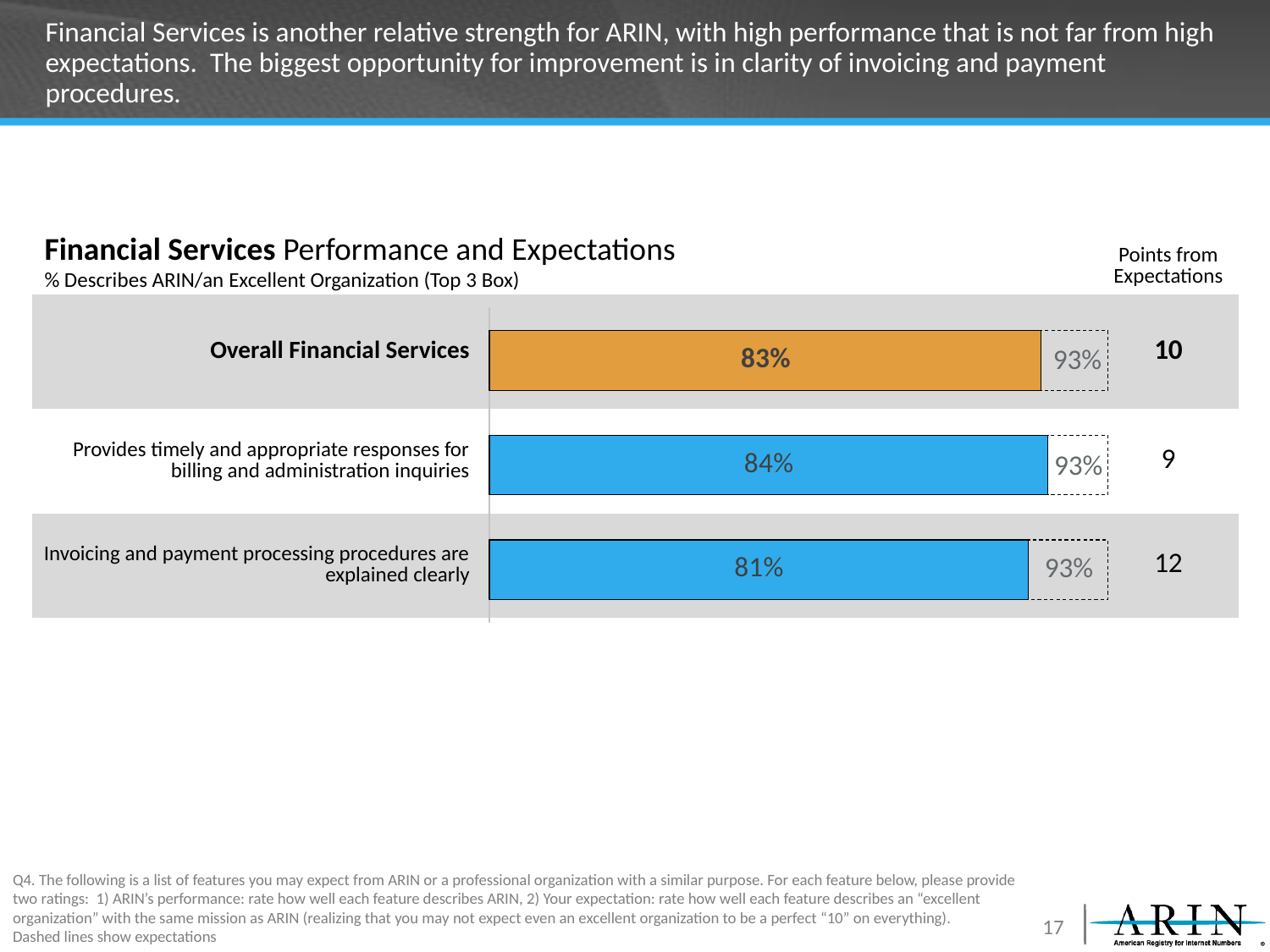
What is the 'Points from Expectations' value for 'Provides timely and appropriate responses for billing and administration inquiries'? 9 What is the performance value for Overall Financial Services? 83% Which category has the lowest performance value? Invoicing and payment processing procedures are explained clearly What kind of chart is this? Bar chart What is the difference between the expectation and performance values for 'Invoicing and payment processing procedures are explained clearly'? 12 What is the expectation value shown for Overall Financial Services? 93% Which is larger: the performance value for Overall Financial Services or for 'Invoicing and payment processing procedures are explained clearly'? Overall Financial Services What is the performance value for 'Invoicing and payment processing procedures are explained clearly'? 81% What do the dashed lines in the chart show? Expectations How many categories are shown in the chart? 3 What is the performance value for 'Provides timely and appropriate responses for billing and administration inquiries'? 84% Which category has the highest performance value? Provides timely and appropriate responses for billing and administration inquiries